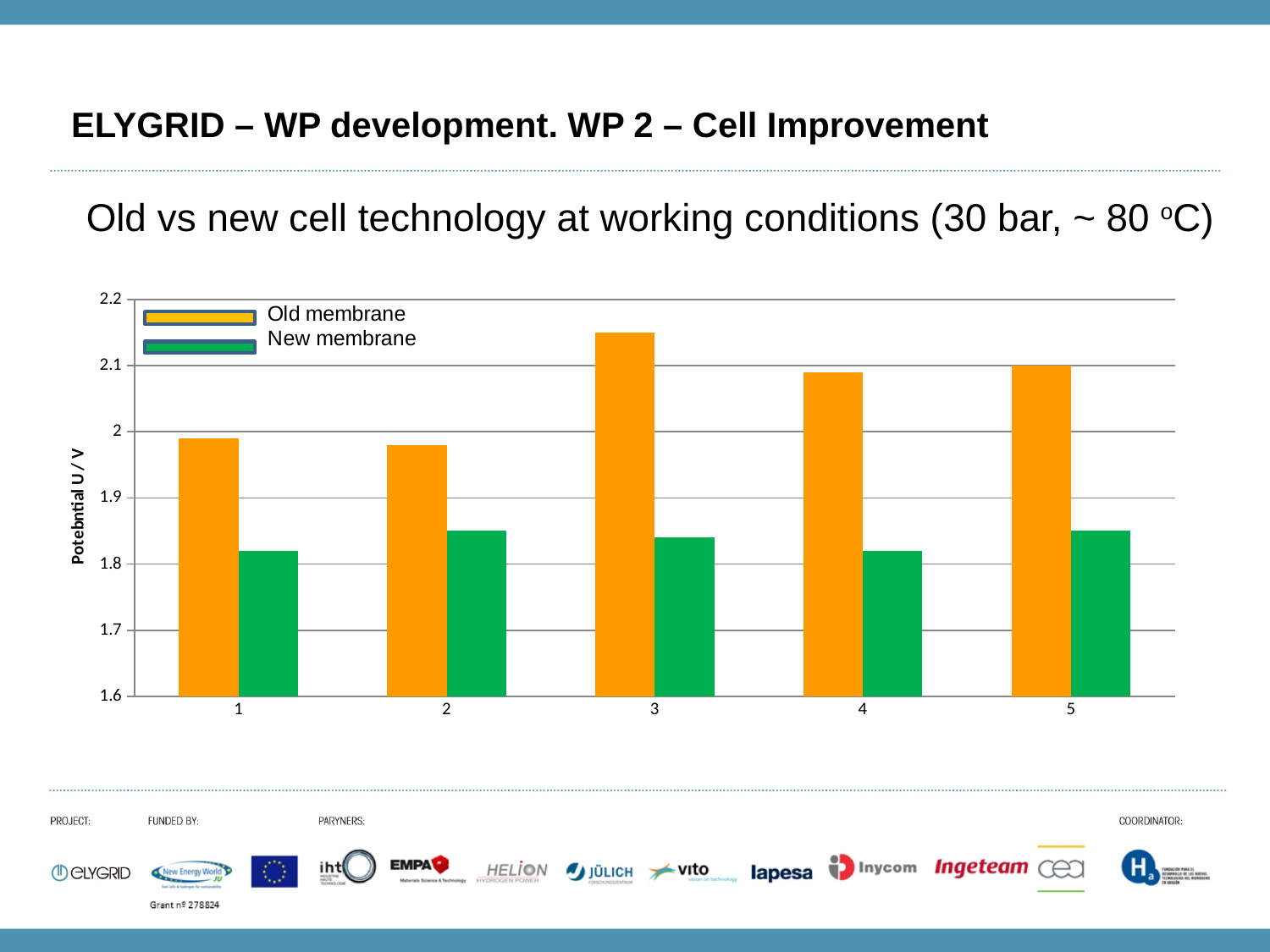
Which category has the highest Old membrane value? 3 How many categories are shown on the x axis? 5 What kind of chart is shown on the slide? bar chart Which is larger, the Old membrane value for category 1 or for category 4? category 4 What colour are the New membrane bars? green Is the New membrane value for category 2 greater or less than 1.8? greater How many series does the legend list? 2 Is the Old membrane value for category 4 greater or less than 2? greater Is the Old membrane value for category 3 greater or less than 2.1? greater For category 3, which series has the larger value, Old membrane or New membrane? Old membrane What are the two entries in the legend? Old membrane, New membrane